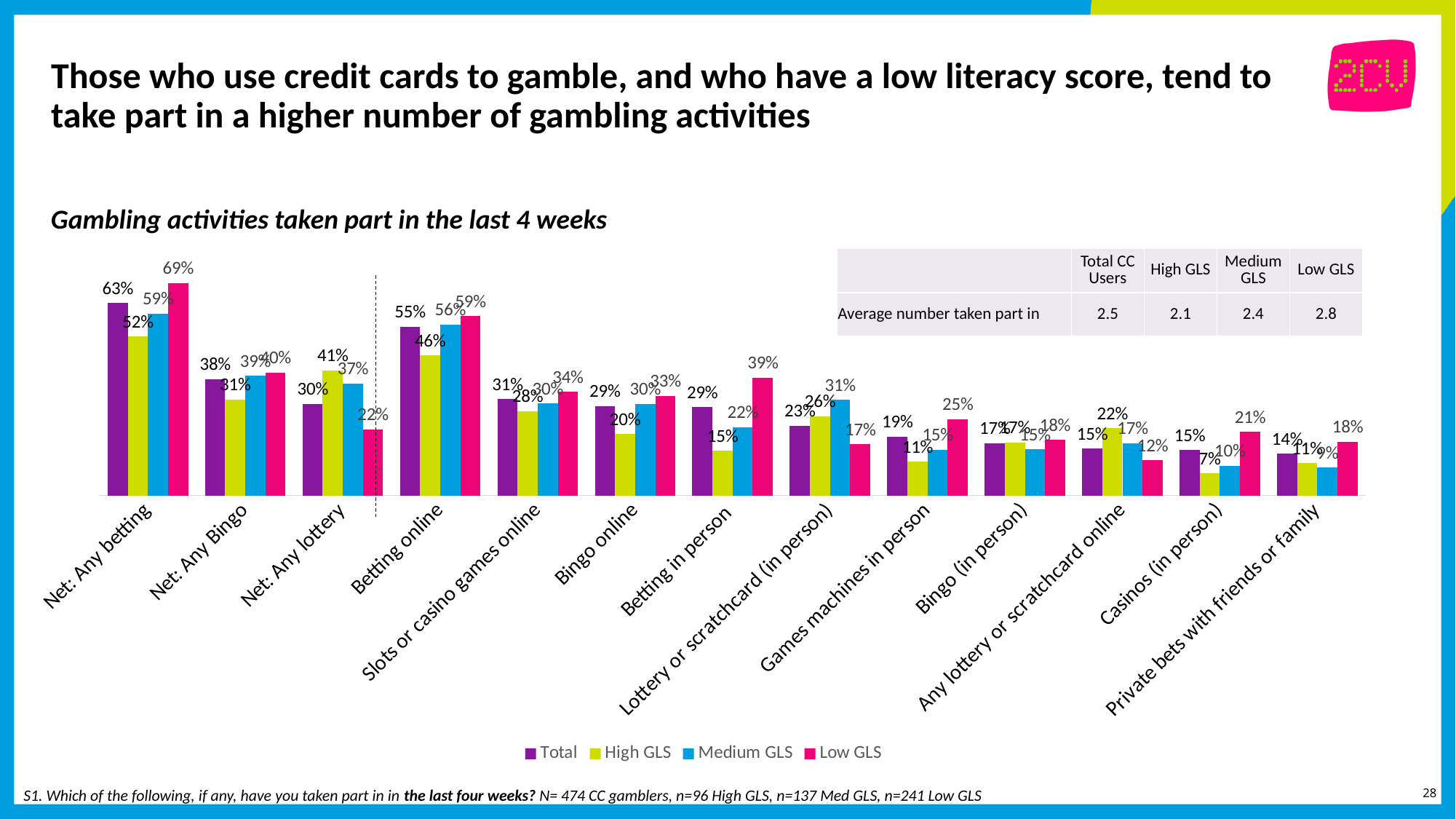
What is the High GLS value for Betting online? 46% Which category has the lowest High GLS value? Casinos (in person) What is the difference between the Low GLS and High GLS values for Betting in person? 24 percentage points How many series does the legend list? 4 What is the Total value for Betting in person? 29% What is the Low GLS value for Net: Any betting? 69% What is the Medium GLS value for Lottery or scratchcard (in person)? 31% For Net: Any lottery, which is larger, the High GLS value or the Low GLS value? High GLS How many categories are shown on the x axis of the chart? 13 What kind of chart is shown on the slide? Bar chart In the table, what is the average number of activities taken part in for Low GLS? 2.8 Which category has the highest Low GLS value? Net: Any betting